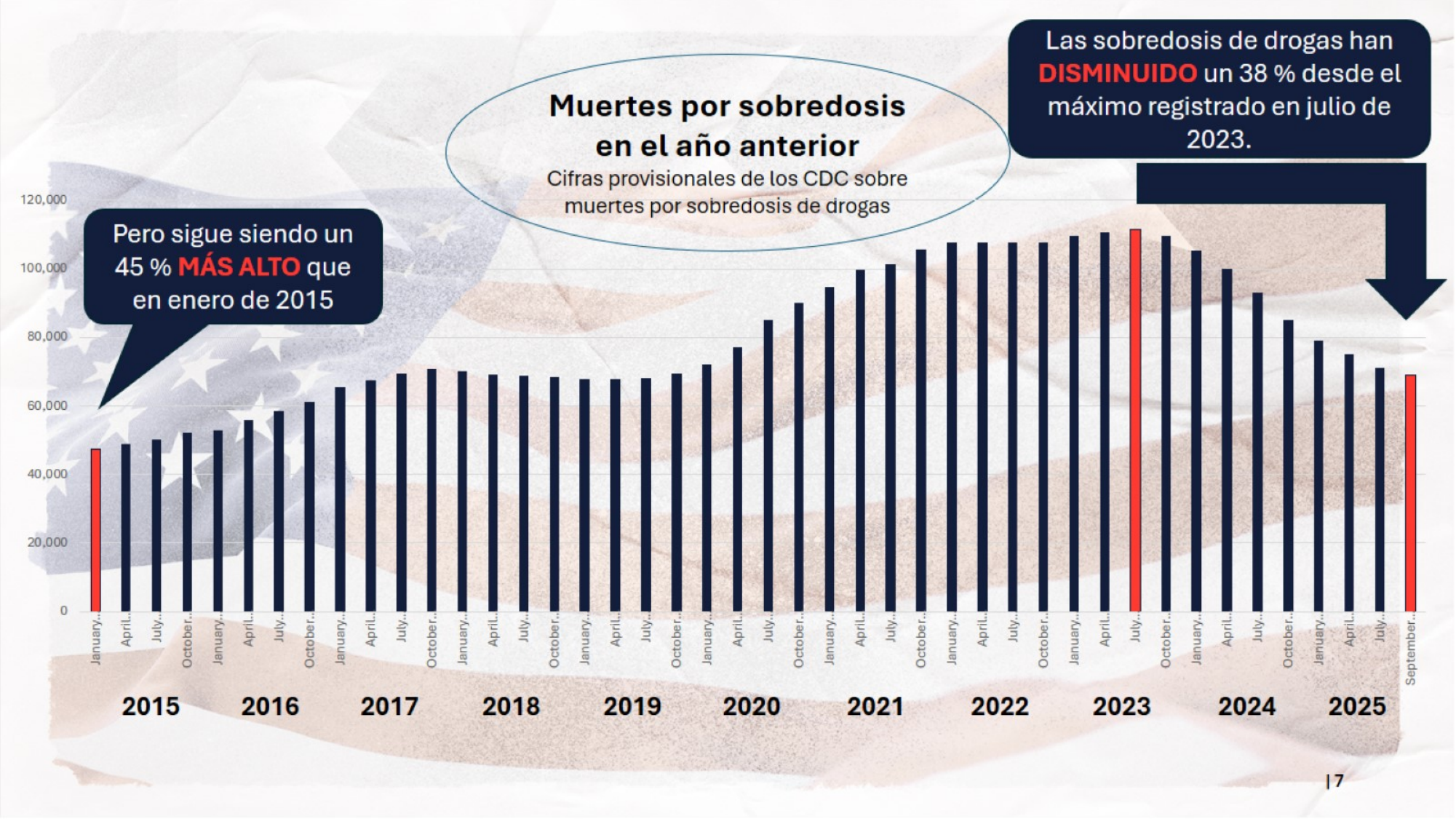
Which is larger, the value for July 2023 or the value for September 2025? July 2023 What kind of chart is shown on the slide? bar chart Do the values rise or fall from July 2023 to September 2025? fall Do the values rise or fall from January 2015 to July 2023? rise Is the value for September 2025 greater or less than 80,000? less What is the title of the chart? Muertes por sobredosis en el año anterior Which period has the lowest bar in the chart? January 2015 Is the value for January 2015 greater or less than 60,000? less Which period has the highest bar in the chart? July 2023 What colour are the highlighted bars for January 2015, July 2023 and September 2025? red Is the value for January 2021 greater or less than 80,000? greater